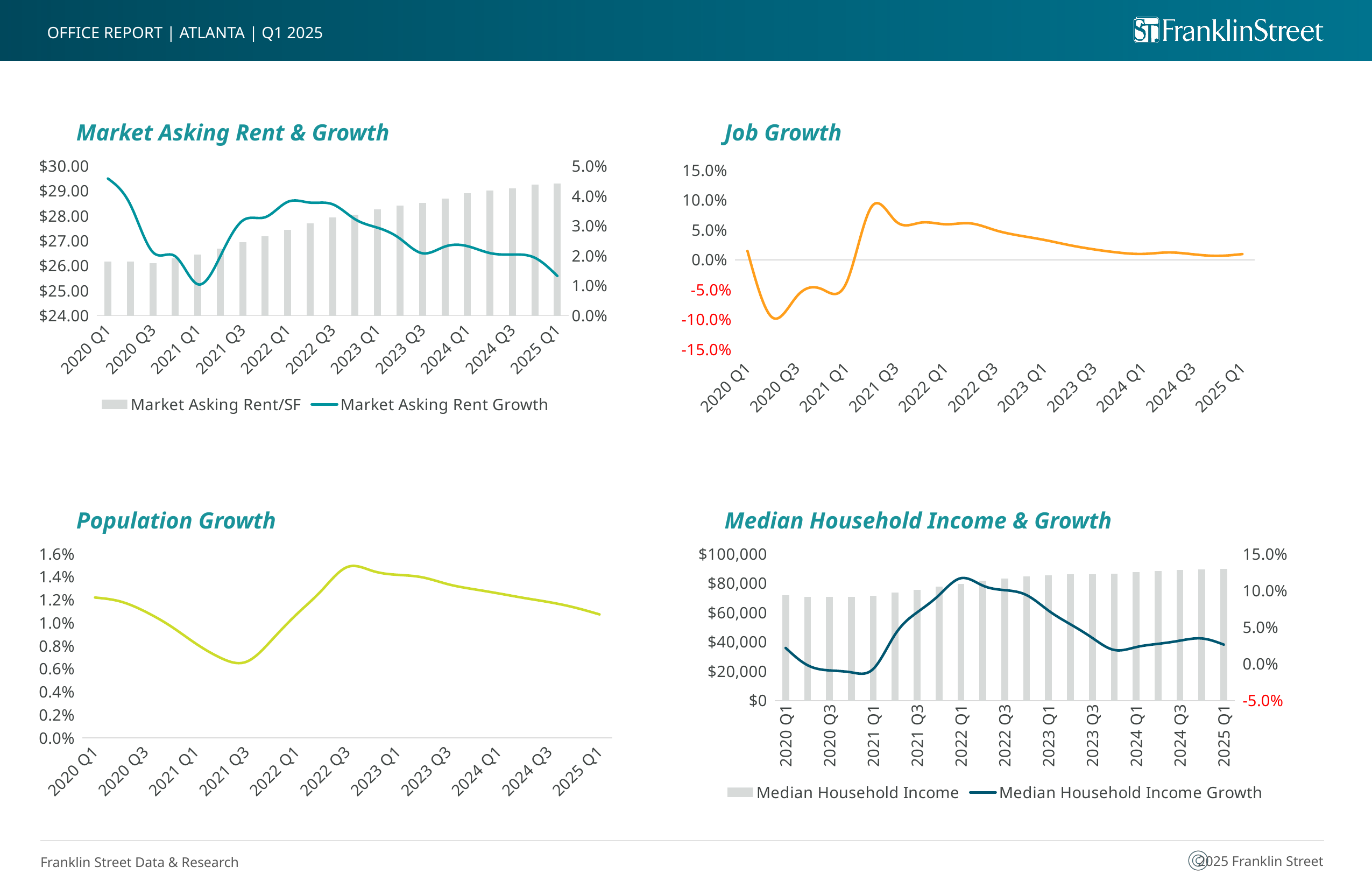
In the Population Growth chart, which quarter has the lowest population growth? 2021 Q3 In the Market Asking Rent & Growth chart, how many series does the legend list? 2 In the Median Household Income & Growth chart, is the Median Household Income for 2025 Q1 greater or less than $80,000? greater What kind of chart is the Job Growth chart? Line chart In the Population Growth chart, is the value for 2022 Q3 greater or less than 1.4%? greater In the Job Growth chart, is the value for 2020 Q3 greater or less than -5.0%? less In the Market Asking Rent & Growth chart, do the Market Asking Rent/SF bars rise or fall from 2021 Q1 to 2025 Q1? rise In the Median Household Income & Growth chart, how many Median Household Income bars are plotted? 21 In the Job Growth chart, does job growth rise or fall from 2021 Q3 to 2025 Q1? fall